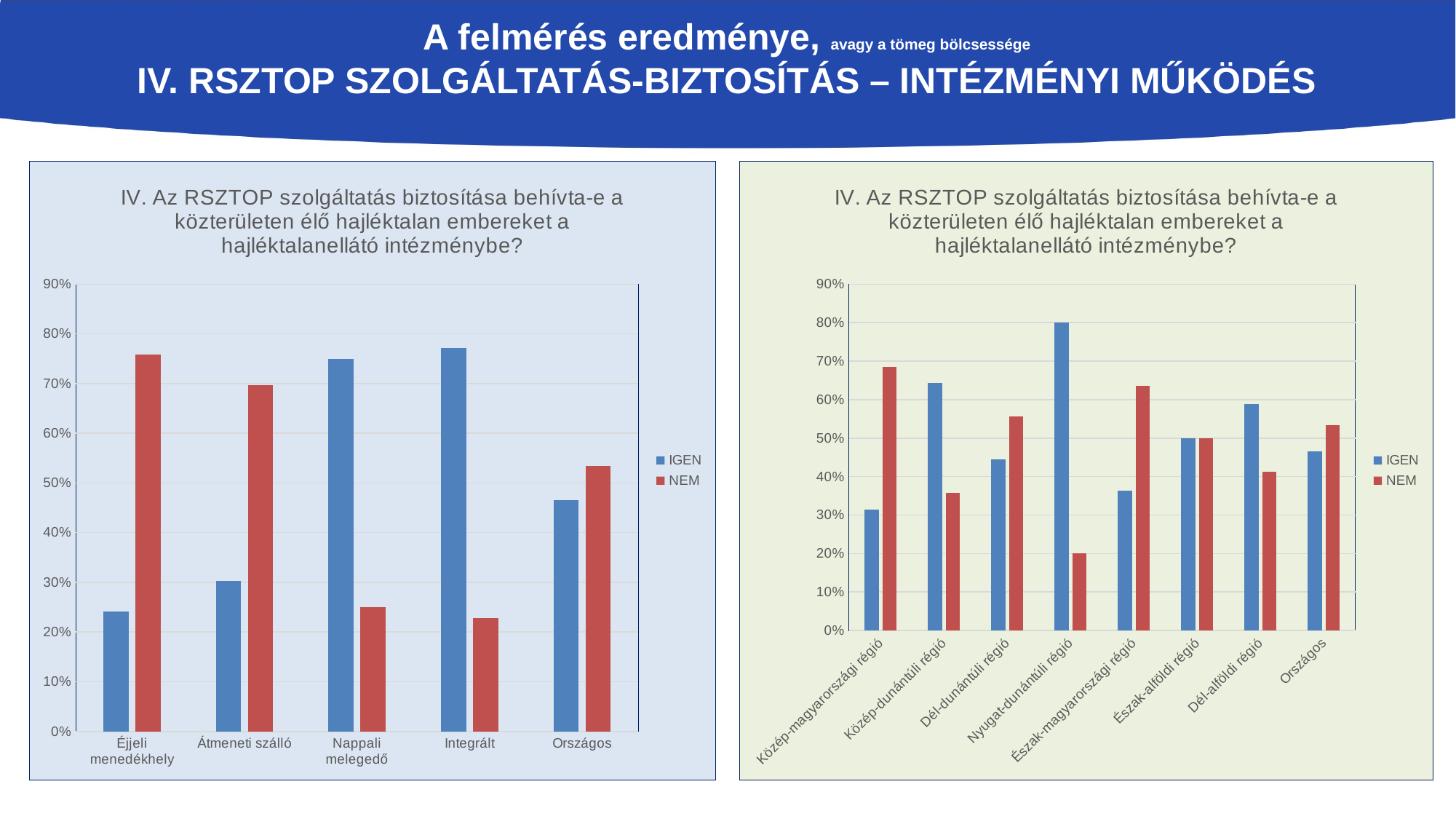
How many categories are shown on the x axis of the left chart? 5 In the left chart, which category has the lowest IGEN value? Éjjeli menedékhely In the left chart, is the IGEN value for Nappali melegedő greater or less than 70%? greater How many series does the legend of the right chart list? 2 In the left chart, which is larger for Országos, IGEN or NEM? NEM How many categories are shown on the x axis of the right chart? 8 In the right chart, which region has the lowest NEM value? Nyugat-dunántúli régió What kind of chart is the left chart? bar chart In the right chart, which region has the highest IGEN value? Nyugat-dunántúli régió In the right chart, which is larger for Észak-magyarországi régió, IGEN or NEM? NEM In the left chart, which category has the highest NEM value? Éjjeli menedékhely In the right chart, is the IGEN value for Közép-dunántúli régió greater or less than 60%? greater